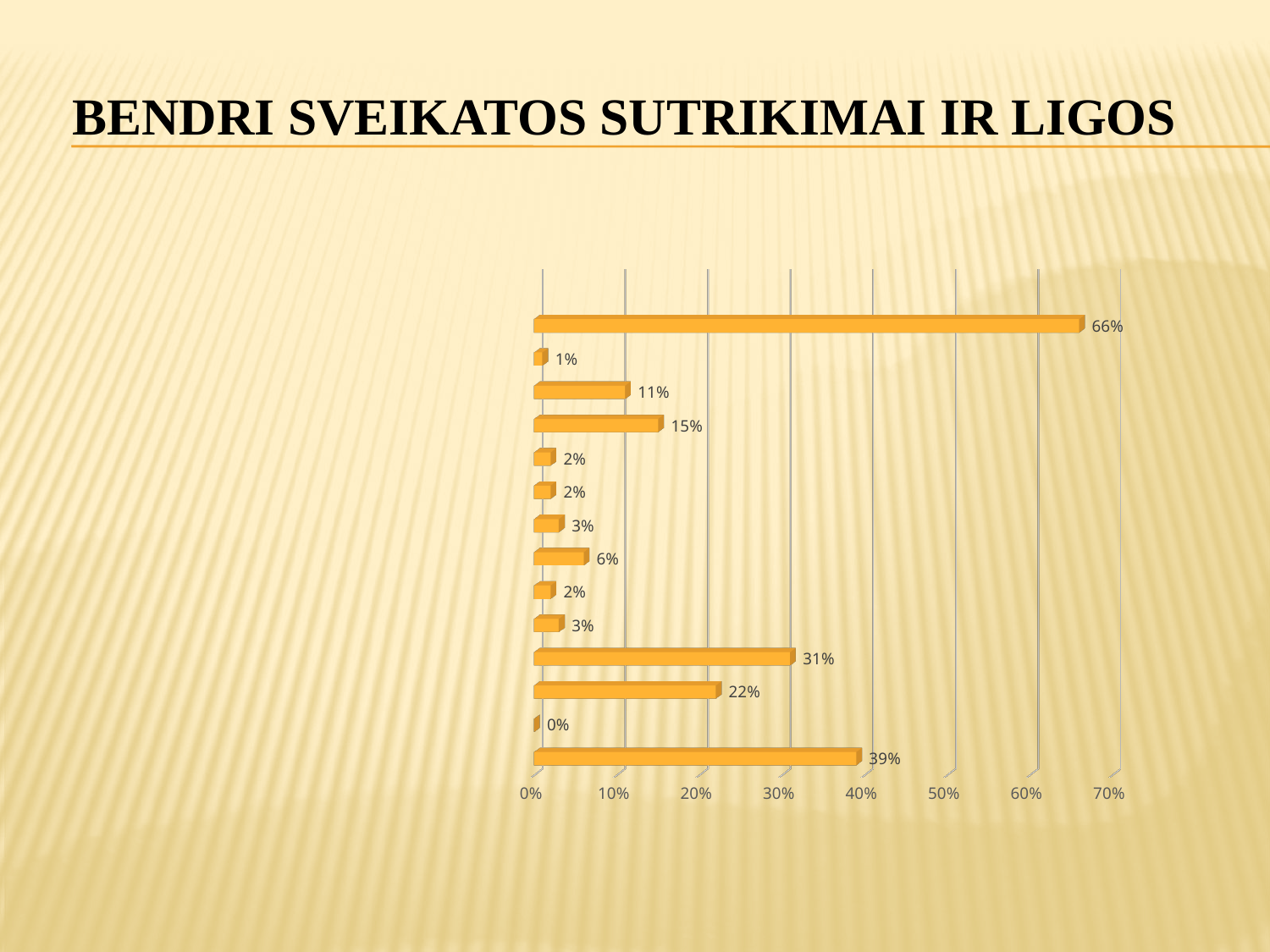
Is the value of the topmost bar greater or less than 60%? greater What is the lowest value shown in the chart? 0% Which is larger: the topmost bar or the bottom bar? the topmost bar (66%) How many bars are plotted in the chart? 14 How many bars in the chart have a value of 2%? 3 What is the title of the slide containing the chart? BENDRI SVEIKATOS SUTRIKIMAI IR LIGOS What is the value of the bottom bar in the chart? 39% What kind of chart is shown on the slide? bar chart What is the difference between the highest value (66%) and the second-highest value (39%) in the chart? 27% What is the highest value shown in the chart? 66% What is the value of the topmost bar in the chart? 66% What is the highest tick value shown on the horizontal axis? 70%